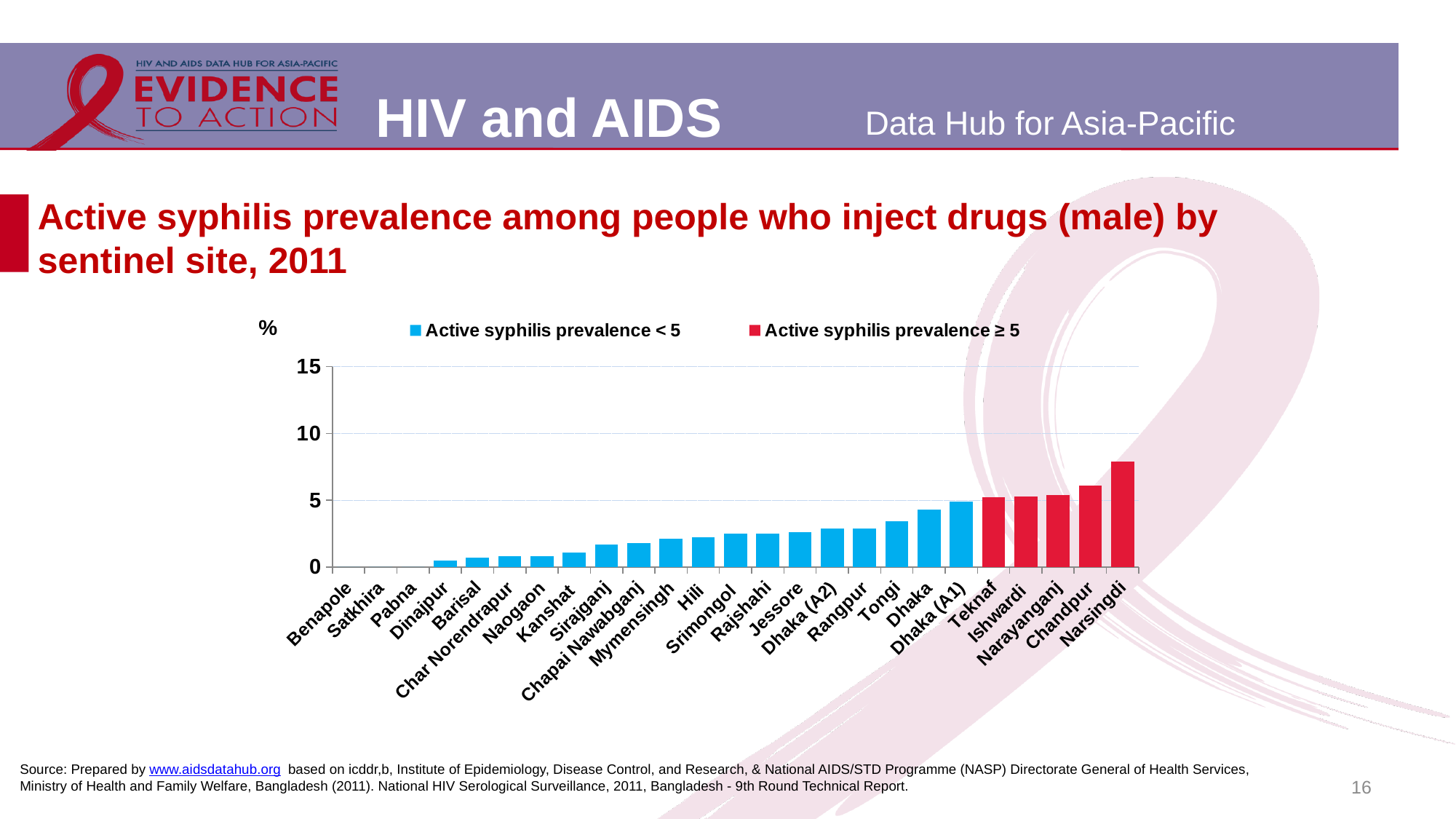
Which has the larger value, Chandpur or Dhaka? Chandpur How many series does the chart legend list? 2 How many sentinel sites are shown on the x axis of the chart? 25 Is the value for Chandpur greater or less than 5? greater What kind of chart is shown on the slide? Bar chart Which has the larger value, Dinajpur or Rangpur? Rangpur Is the value for Narsingdi greater or less than 5? greater Is the value for Tongi greater or less than 5? less Which sentinel site has the highest active syphilis prevalence in the chart? Narsingdi Do the values rise or fall moving from left to right along the x axis? Rise What colour are the bars for sites with active syphilis prevalence ≥ 5? Red